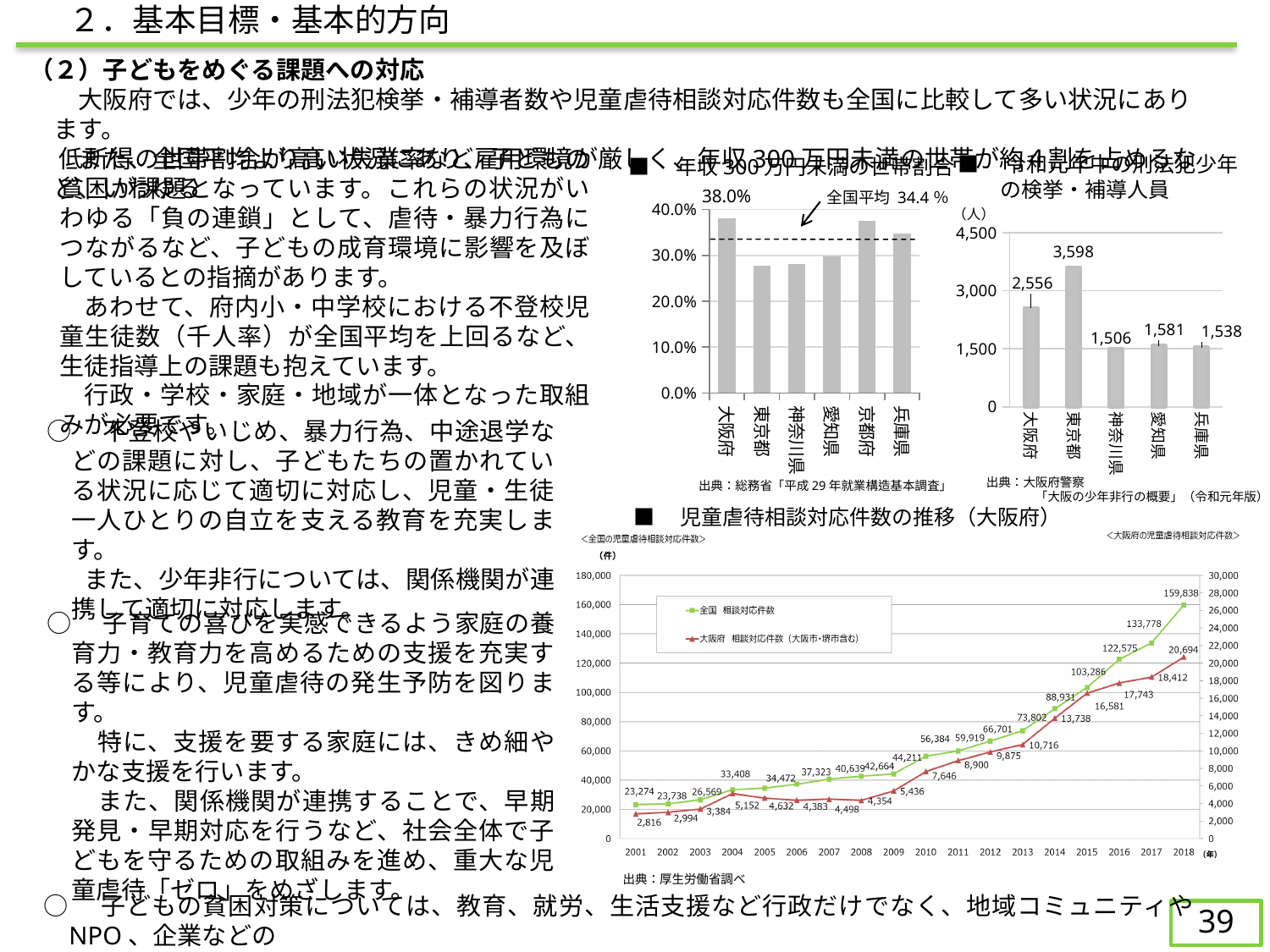
In the bottom line chart (児童虐待相談対応件数の推移), does the 全国 series generally rise or fall from 2001 to 2018? rise In the top-right bar chart (令和元年中の刑法犯少年の検挙・補導人員), what is the value for 東京都? 3,598 In the bottom line chart (児童虐待相談対応件数の推移), what is the 全国 value for 2018? 159,838 In the bottom line chart (児童虐待相談対応件数の推移), how many series does the legend list? 2 In the top-right bar chart (令和元年中の刑法犯少年の検挙・補導人員), how many prefectures are shown? 5 In the bottom line chart (児童虐待相談対応件数の推移), what is the 大阪府 value for 2001? 2,816 In the top-right bar chart (令和元年中の刑法犯少年の検挙・補導人員), which prefecture has the lowest value? 神奈川県 In the top-left bar chart (年収300万円未満の世帯割合), what is the value for 大阪府? 38.0% In the top-right bar chart (令和元年中の刑法犯少年の検挙・補導人員), what is the value for 大阪府? 2,556 In the top-left bar chart (年収300万円未満の世帯割合), is the value for 東京都 greater or less than 30.0%? less In the top-right bar chart (令和元年中の刑法犯少年の検挙・補導人員), what is the difference between 東京都 and 大阪府? 1,042 In the top-left bar chart (年収300万円未満の世帯割合), which prefecture has the highest value? 大阪府